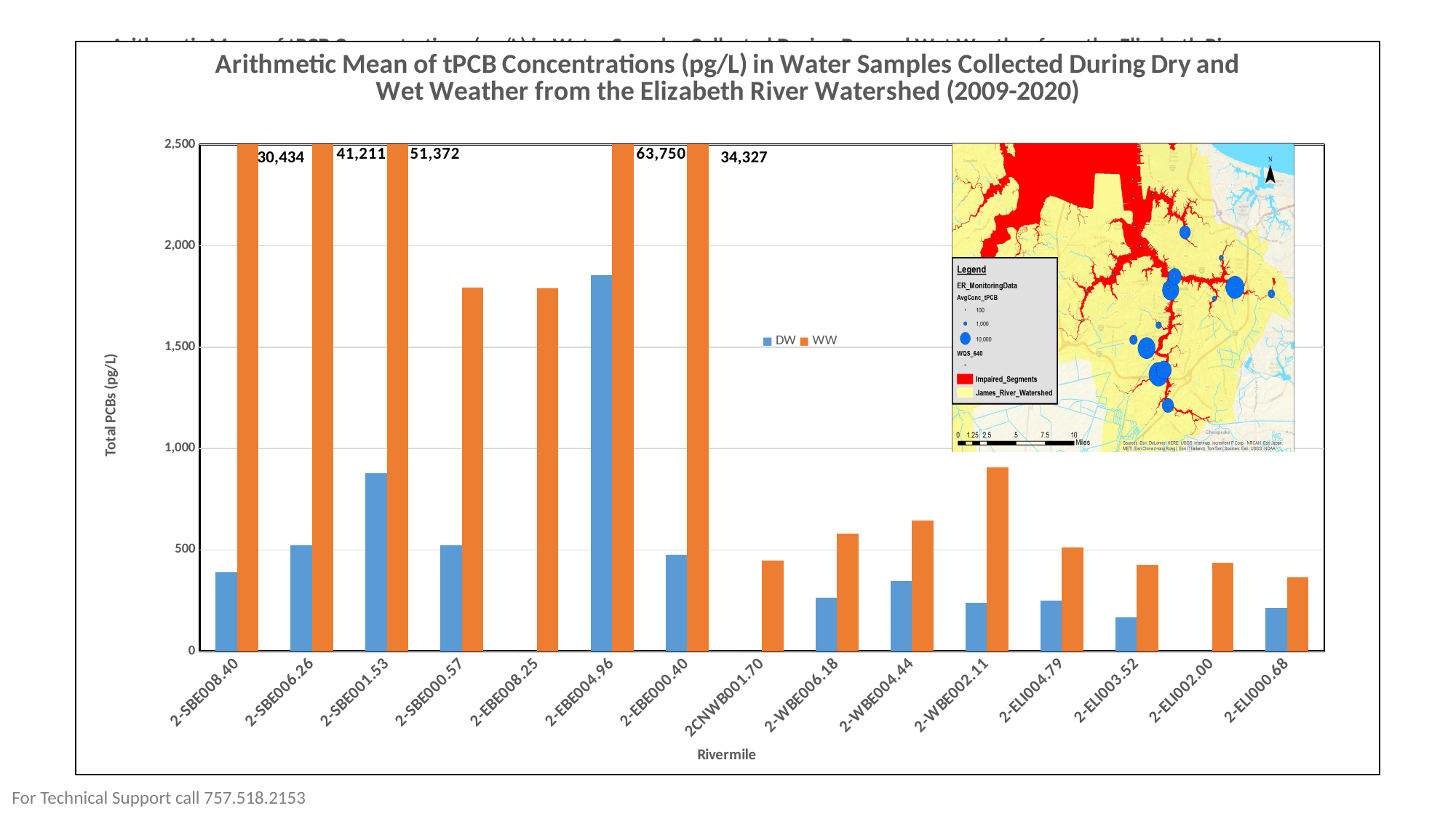
How many series does the legend list? 2 Which rivermile has the highest WW value? 2-EBE004.96 Is the WW value for 2-WBE002.11 greater or less than 1,000? less What is the WW value labelled for 2-EBE004.96? 63,750 Which is larger for 2-SBE001.53, the DW value or the WW value? WW Which rivermile has the highest DW value? 2-EBE004.96 What is the WW value labelled for 2-SBE008.40? 30,434 What is the WW value labelled for 2-SBE001.53? 51,372 What is the difference between the labelled WW values for 2-SBE001.53 and 2-SBE006.26? 10,161 What is the difference between the labelled WW values for 2-EBE004.96 and 2-SBE008.40? 33,316 Is the DW value for 2-EBE004.96 greater or less than 1,500? greater How many rivermile categories are shown on the x axis? 15